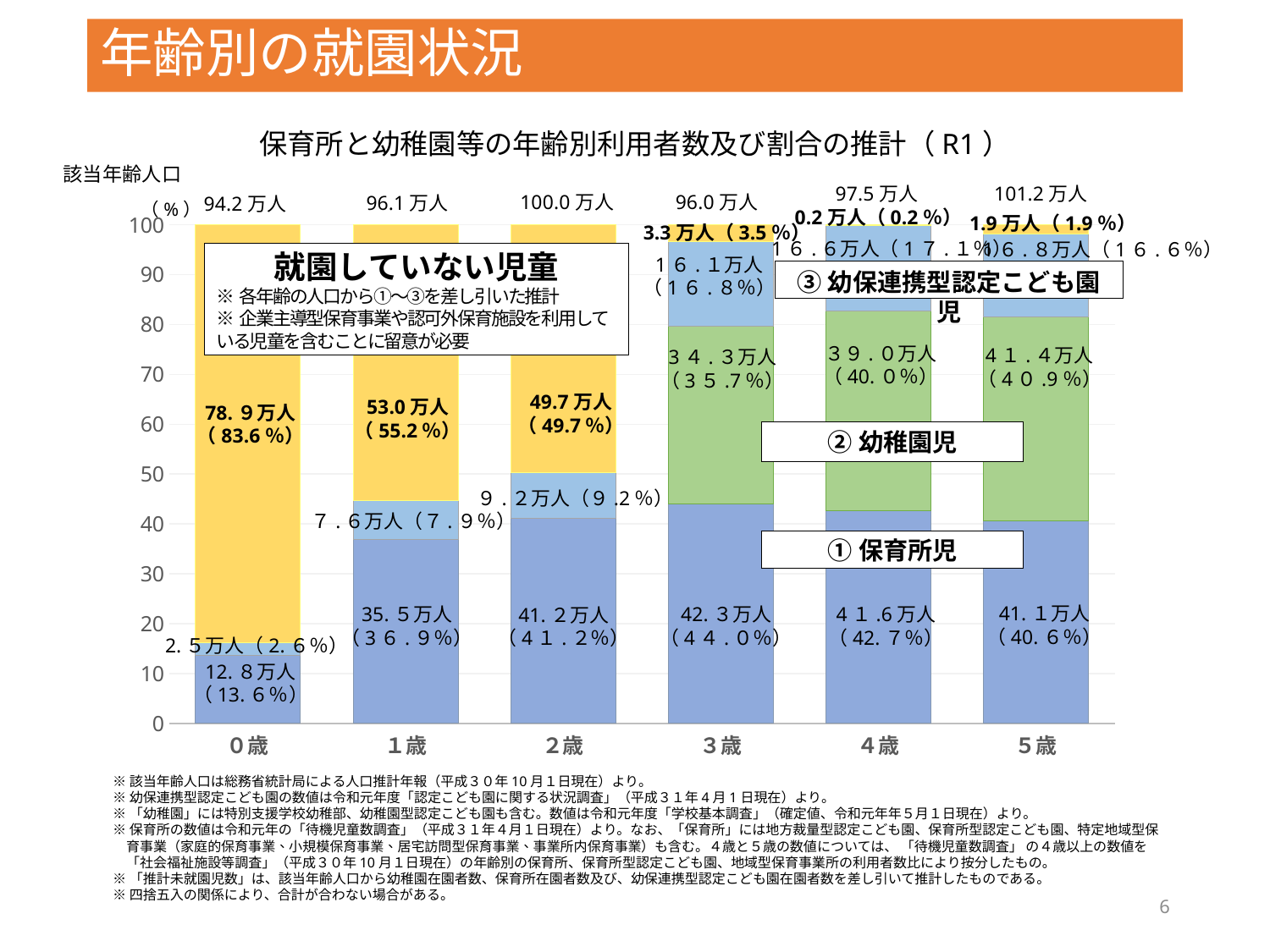
Which age group has the highest share of 就園していない児童? 0歳 For 3歳, which is larger: the number of 保育所児 or the number of 幼稚園児? 保育所児 What is the number of 幼保連携型認定こども園児 (③) for 4歳? 16.6万人 Which age group has the lowest share of 就園していない児童? 4歳 What percentage of 3歳 children are 幼稚園児 (②)? 35.7% How many age categories are shown on the x axis? 6 What is the 該当年齢人口 shown above the 5歳 bar? 101.2万人 Does the share of 保育所児 rise or fall from 0歳 to 3歳? Rise What kind of chart is shown on the slide? Stacked bar chart How many more 保育所児 (in 万人) are there at 1歳 than at 0歳? 22.7万人 What is the number of 保育所児 (①) for 0歳? 12.8万人 What is the number and share of 就園していない児童 for 2歳? 49.7万人（49.7%）